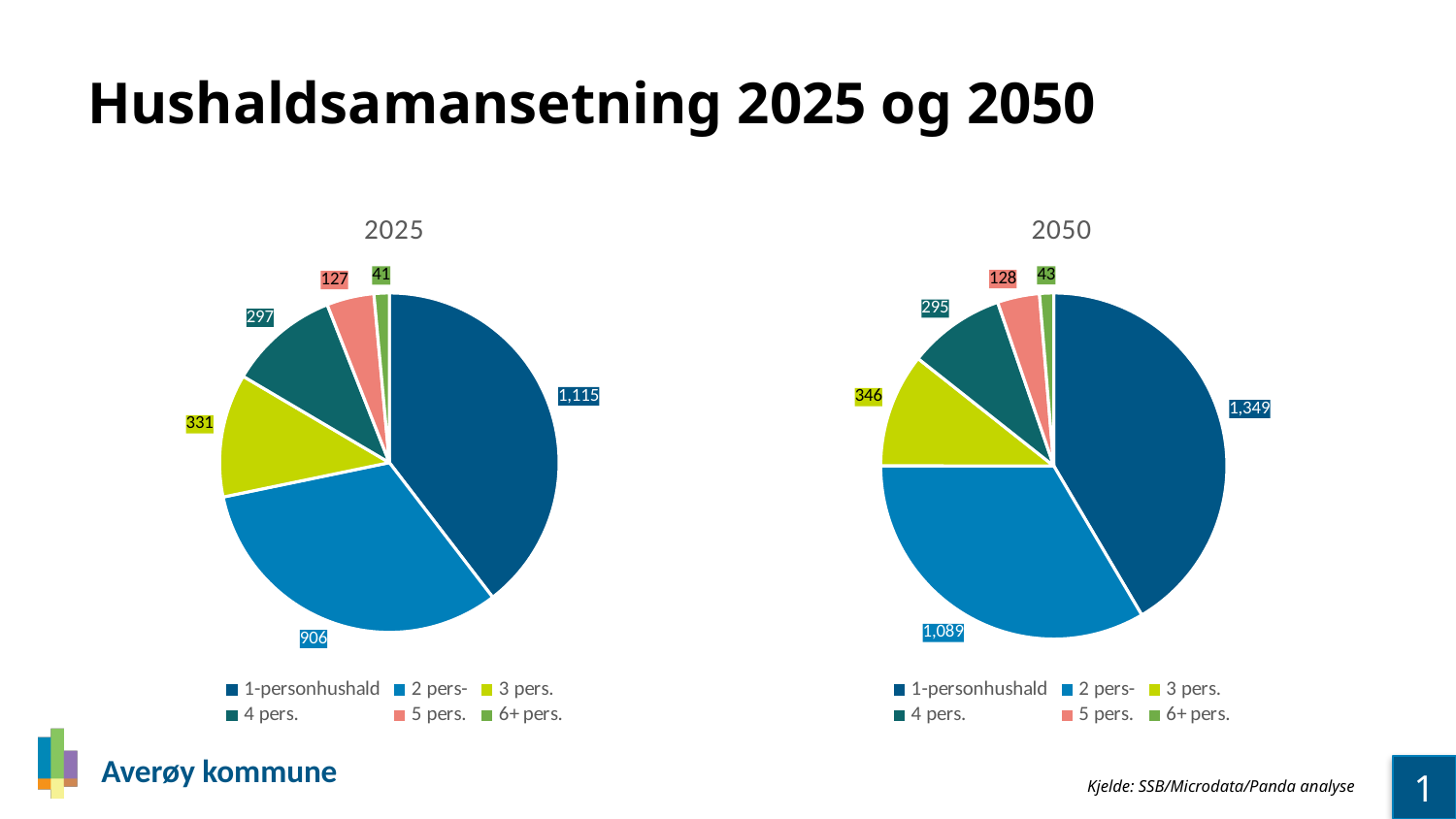
What is the difference between the 1-personhushald value in the 2050 chart and the 1-personhushald value in the 2025 chart? 234 What is the title of the chart on the right side of the slide? 2050 Which is larger: the 3 pers. value in the 2025 chart or the 3 pers. value in the 2050 chart? 2050 In the 2050 pie chart, what is the value for 2 pers-? 1,089 In the 2050 pie chart, which category has the largest slice? 1-personhushald How many slices does the 2050 pie chart have? 6 What type of chart is used for the 2025 data? Pie chart In the 2050 pie chart, what is the value for 6+ pers.? 43 In the 2025 pie chart, what is the value for 3 pers.? 331 In the 2025 pie chart, which category has the smallest slice? 6+ pers. In the 2025 pie chart, what is the difference between the values for 4 pers. and 5 pers.? 170 In the 2025 pie chart, what is the value for 1-personhushald? 1,115